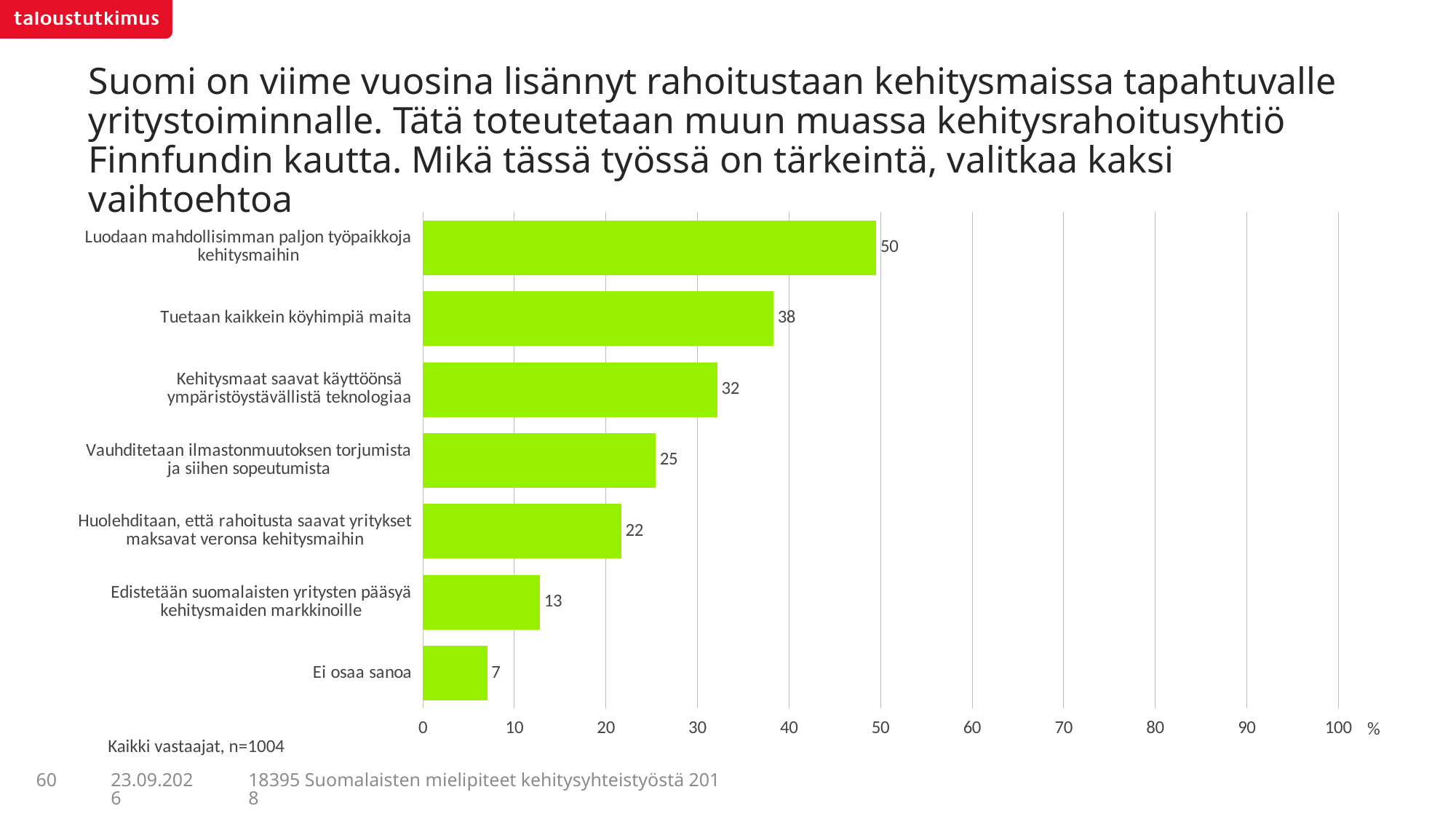
What is the value for "Ei osaa sanoa"? 7 Is the value for "Kehitysmaat saavat käyttöönsä ympäristöystävällistä teknologiaa" greater or less than 30? greater Which category has the lowest value? Ei osaa sanoa What is the value for "Luodaan mahdollisimman paljon työpaikkoja kehitysmaihin"? 50 What is the value for "Edistetään suomalaisten yritysten pääsyä kehitysmaiden markkinoille"? 13 What kind of chart is shown on the slide? bar chart How many categories are shown in the chart? 7 Which category has the highest value? Luodaan mahdollisimman paljon työpaikkoja kehitysmaihin What is the value for "Tuetaan kaikkein köyhimpiä maita"? 38 What is the difference between the values for "Tuetaan kaikkein köyhimpiä maita" and "Kehitysmaat saavat käyttöönsä ympäristöystävällistä teknologiaa"? 6 Which is larger: the value for "Vauhditetaan ilmastonmuutoksen torjumista ja siihen sopeutumista" or the value for "Huolehditaan, että rahoitusta saavat yritykset maksavat veronsa kehitysmaihin"? Vauhditetaan ilmastonmuutoksen torjumista ja siihen sopeutumista What is the sample size stated below the chart? n=1004